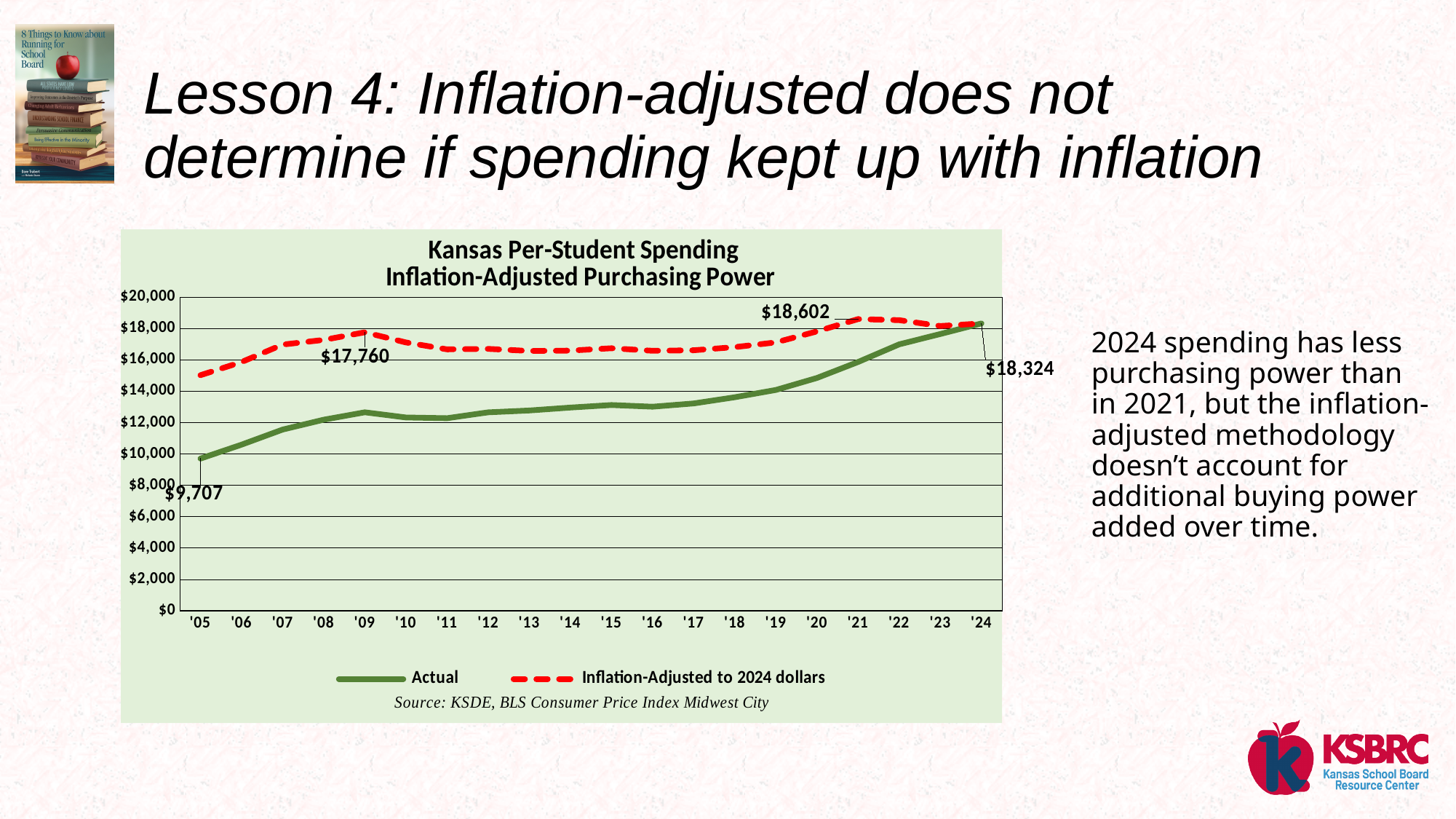
By how much did Actual per-student spending increase from '05 to '24, using the labelled values? $8,617 How many years are plotted along the x axis? 20 Does the Actual line generally rise or fall from '05 to '24? Rise What is the Actual per-student spending value shown for '24? $18,324 Is the Actual value for '15 greater or less than $14,000? less What is the Actual per-student spending value shown for '05? $9,707 What is the Inflation-Adjusted to 2024 dollars value labelled for '21? $18,602 In '05, which series has the higher value, Actual or Inflation-Adjusted to 2024 dollars? Inflation-Adjusted to 2024 dollars What kind of chart is shown on the slide? Line chart What is the difference between the labelled Inflation-Adjusted values for '21 and '09? $842 What is the Inflation-Adjusted to 2024 dollars value labelled for '09? $17,760 How many series does the legend list? 2